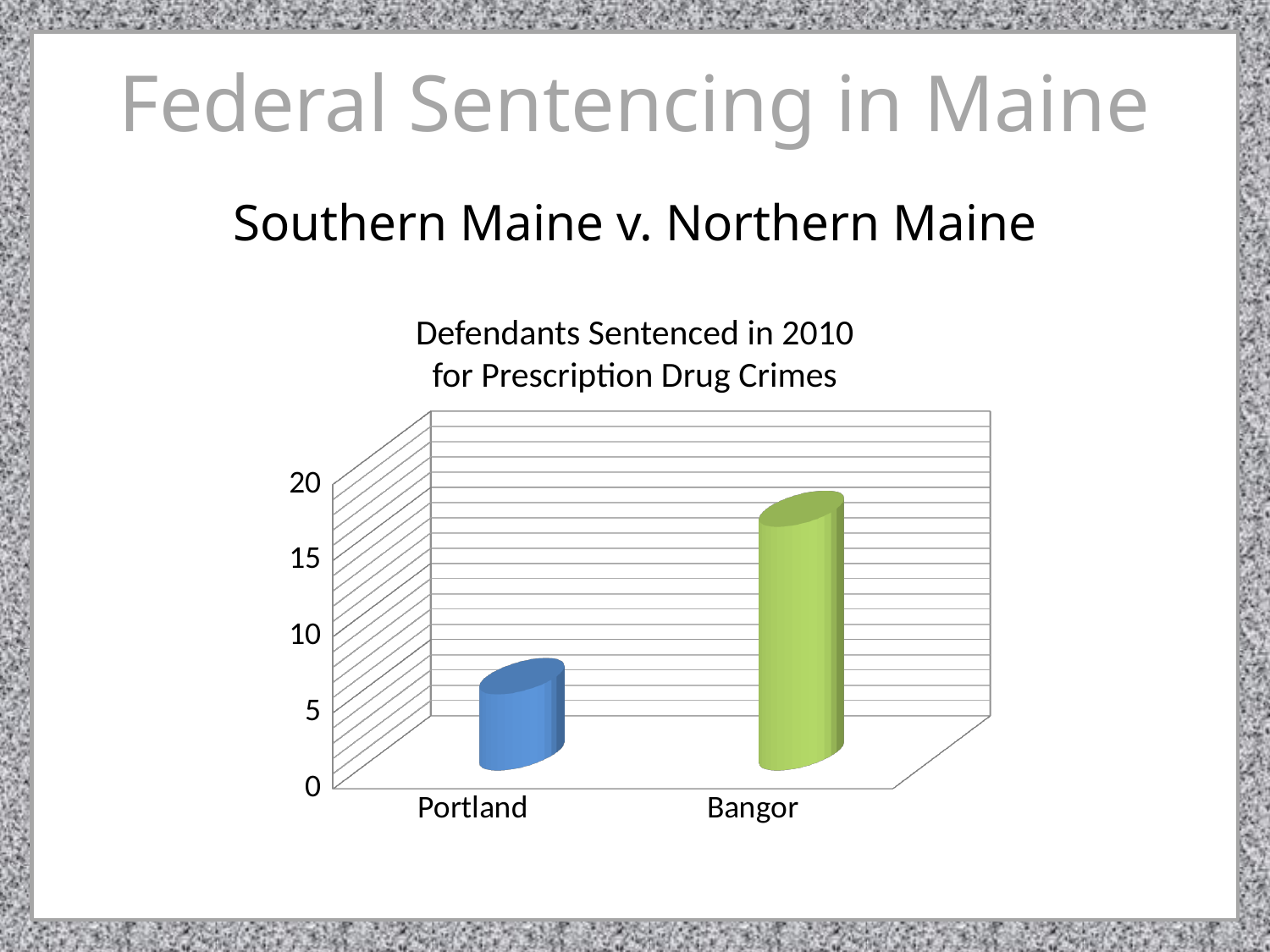
Is the value for Portland greater or less than 10? less Is the value for Portland greater or less than 15? less What type of chart is shown on the slide? bar chart Which category has the lowest number of defendants sentenced? Portland What is the highest value shown on the vertical axis of the chart? 20 Which has a larger value, Portland or Bangor? Bangor What is the title of the chart? Defendants Sentenced in 2010 for Prescription Drug Crimes Which category has the highest number of defendants sentenced? Bangor How many categories are shown on the x axis of the chart? 2 Is the value for Bangor greater or less than 10? greater What colour is the bar for Bangor? green